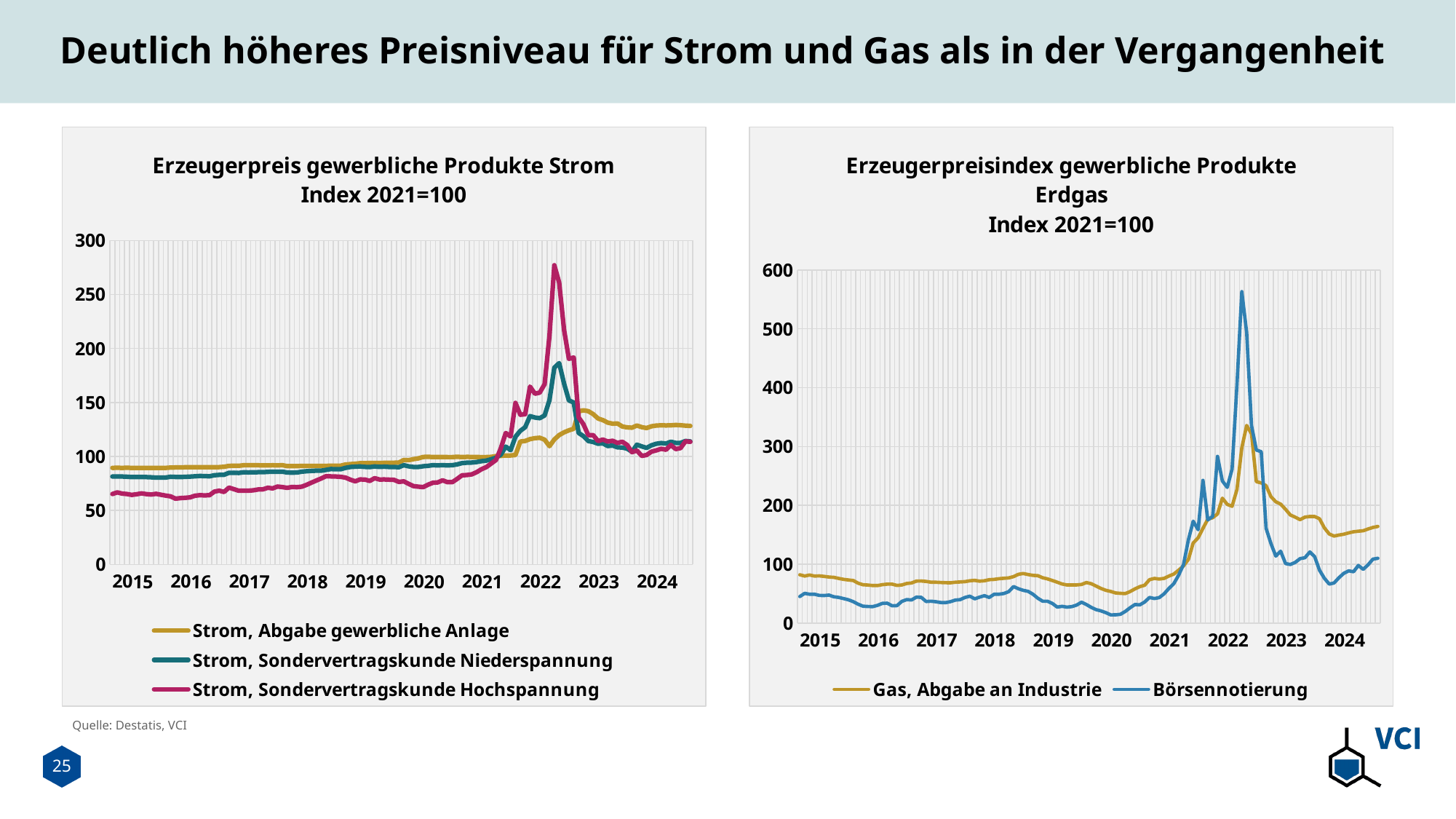
What kind of chart is the left chart, 'Erzeugerpreis gewerbliche Produkte Strom'? line chart In the right chart (Erdgas), is the peak value of 'Gas, Abgabe an Industrie' greater or less than 400? less How many series does the legend of the right chart (Erdgas) list? 2 In the right chart (Erdgas), which series reaches the higher peak, 'Gas, Abgabe an Industrie' or 'Börsennotierung'? Börsennotierung In the left chart (Strom), which series reaches the highest peak in 2022? Strom, Sondervertragskunde Hochspannung In the left chart (Strom), is the peak value of 'Strom, Sondervertragskunde Niederspannung' in 2022 greater or less than 200? less In the left chart (Strom), is the peak value of 'Strom, Sondervertragskunde Hochspannung' in 2022 greater or less than 250? greater How many series does the legend of the left chart (Strom) list? 3 What is the title of the right chart? Erzeugerpreisindex gewerbliche Produkte Erdgas Index 2021=100 In the right chart (Erdgas), does 'Gas, Abgabe an Industrie' rise or fall from its 2022 peak to 2024? fall